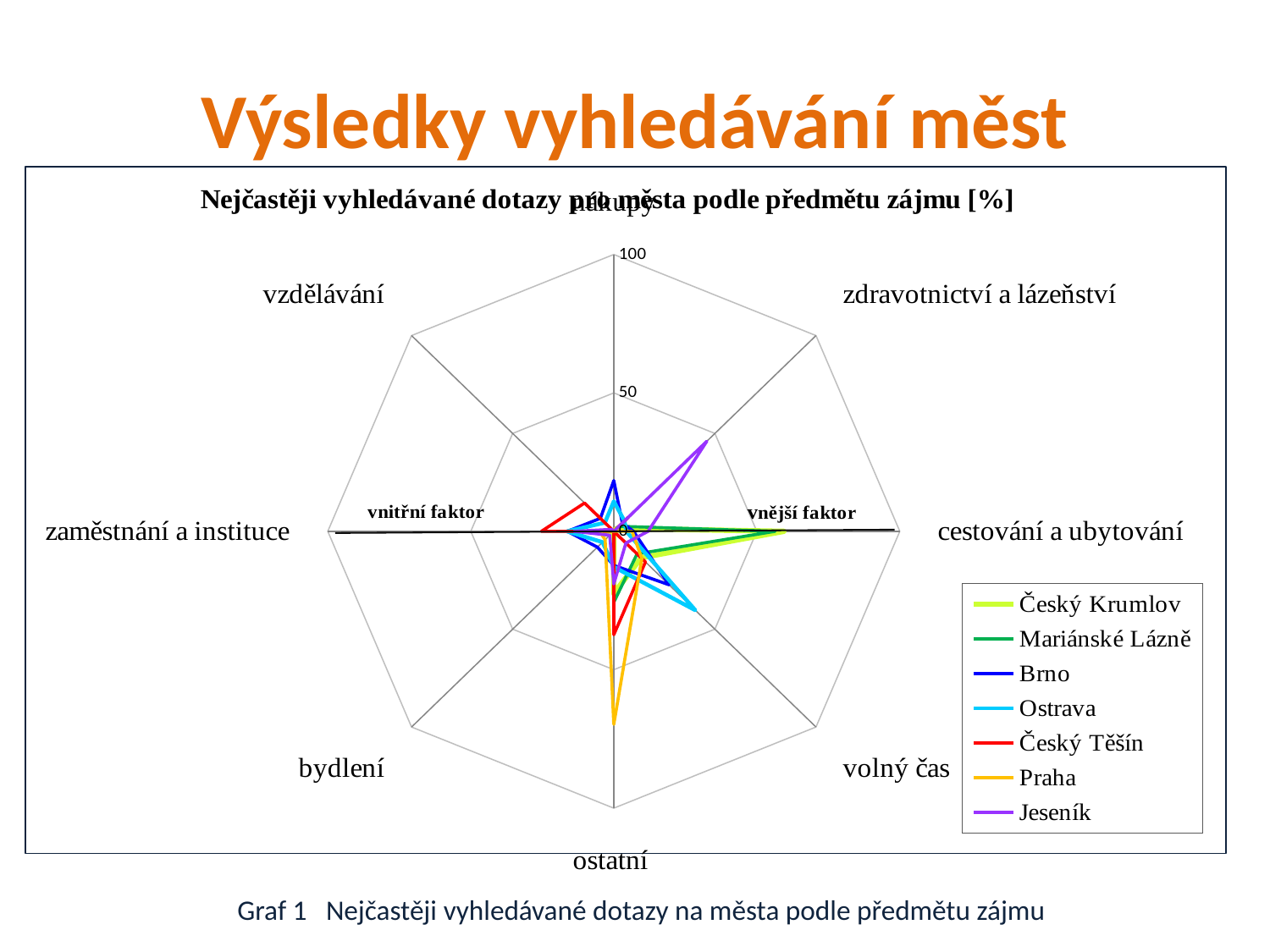
What kind of chart is shown on the slide? radar chart In the category 'ostatní', which is larger: the value for Praha or the value for Brno? Praha Is the value for Český Těšín in the category 'zaměstnání a instituce' greater or less than 50? less Is the value for Praha in the category 'ostatní' greater or less than 50? greater Which city has the highest value in the category 'zdravotnictví a lázeňství'? Jeseník Is the value for Český Krumlov in the category 'cestování a ubytování' greater or less than 50? greater Which city is listed first in the legend? Český Krumlov Which city has the highest value in the category 'ostatní'? Praha How many categories (axes) does the radar chart have? 8 How many series does the legend list? 7 What is the title of the chart? Nejčastěji vyhledávané dotazy pro města podle předmětu zájmu [%]